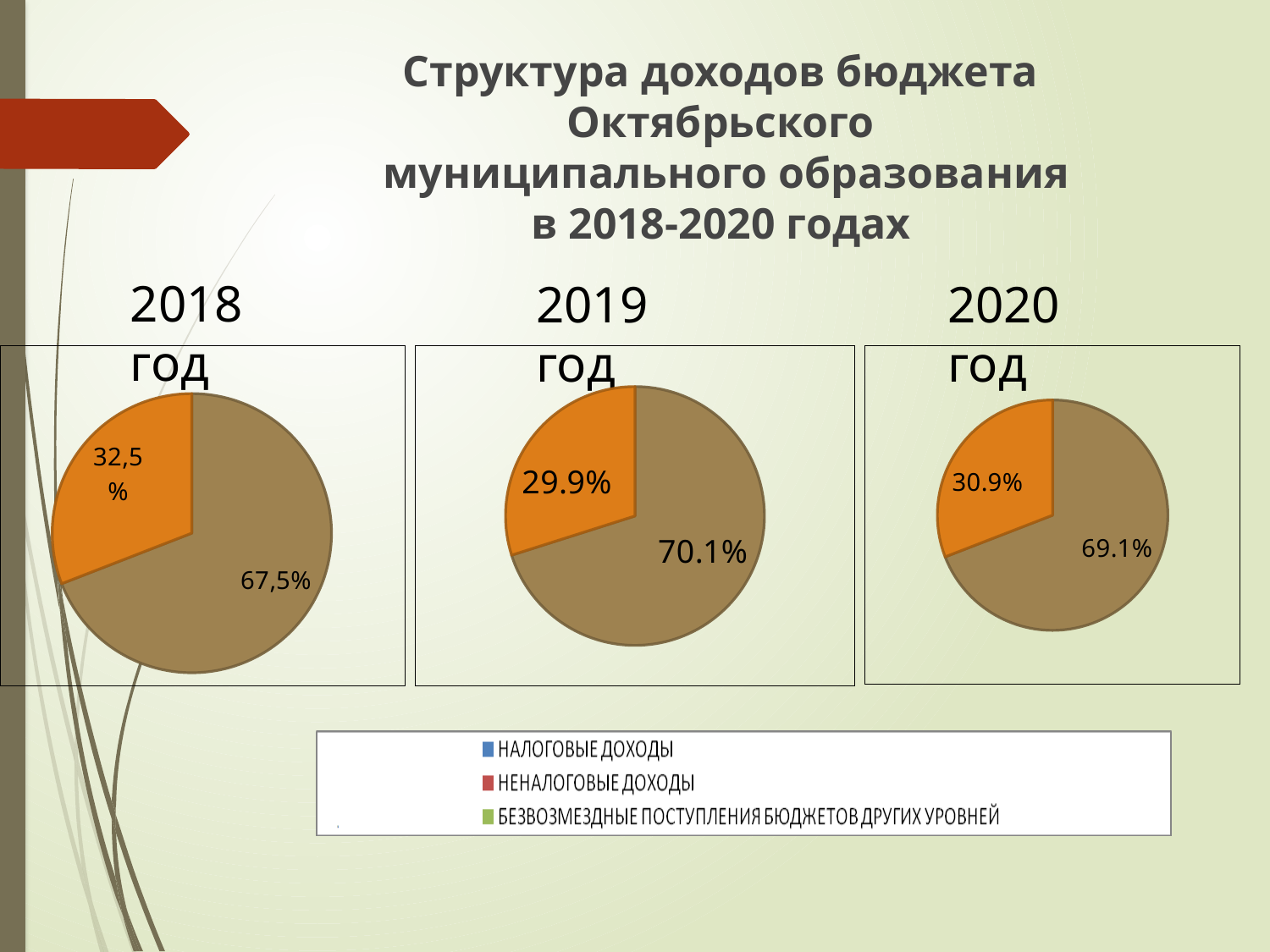
In the 2019 год pie chart, which slice is larger, the orange one or the brown one? The brown one In the 2020 год pie chart, what share does the brown slice have? 69.1% How many pie charts are on the slide? 3 In the 2020 год pie chart, what is the difference between the brown slice and the orange slice? 38.2% In the 2019 год pie chart, what share does the brown slice have? 70.1% In the 2019 год pie chart, what share does the orange slice have? 29.9% How many entries does the legend at the bottom of the slide list? 3 In the 2018 год pie chart, what share does the orange slice have? 32,5% What kind of charts are shown on the slide? Pie charts How many slices does each pie chart have? 2 In the 2018 год pie chart, what share does the brown slice have? 67,5% In the 2020 год pie chart, what share does the orange slice have? 30.9%